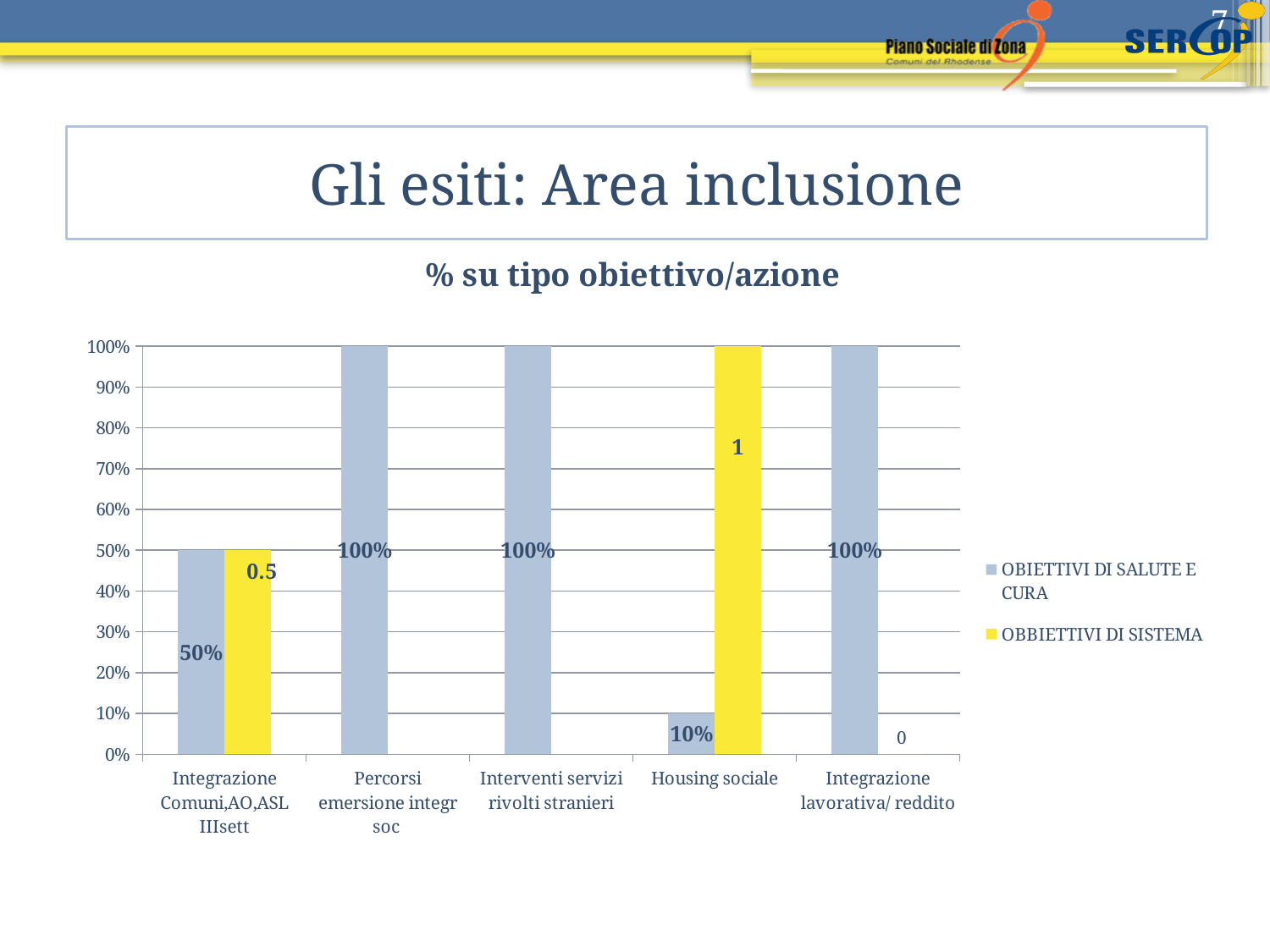
What is the value for OBIETTIVI DI SALUTE E CURA in the Housing sociale category? 10% What is the value for OBIETTIVI DI SALUTE E CURA in the Percorsi emersione integr soc category? 100% What data label is shown for OBBIETTIVI DI SISTEMA in the Integrazione Comuni,AO,ASL IIIsett category? 0.5 What is the value for OBIETTIVI DI SALUTE E CURA in the Integrazione Comuni,AO,ASL IIIsett category? 50% How many series does the legend list? 2 Which category has the lowest value for OBIETTIVI DI SALUTE E CURA? Housing sociale What data label is shown for OBBIETTIVI DI SISTEMA in the Integrazione lavorativa/ reddito category? 0 In the Housing sociale category, which series has the larger value, OBIETTIVI DI SALUTE E CURA or OBBIETTIVI DI SISTEMA? OBBIETTIVI DI SISTEMA How many categories are shown on the x axis? 5 What data label is shown for OBBIETTIVI DI SISTEMA in the Housing sociale category? 1 What is the title of the chart? % su tipo obiettivo/azione What is the difference between the OBIETTIVI DI SALUTE E CURA values for Interventi servizi rivolti stranieri and Housing sociale? 90%